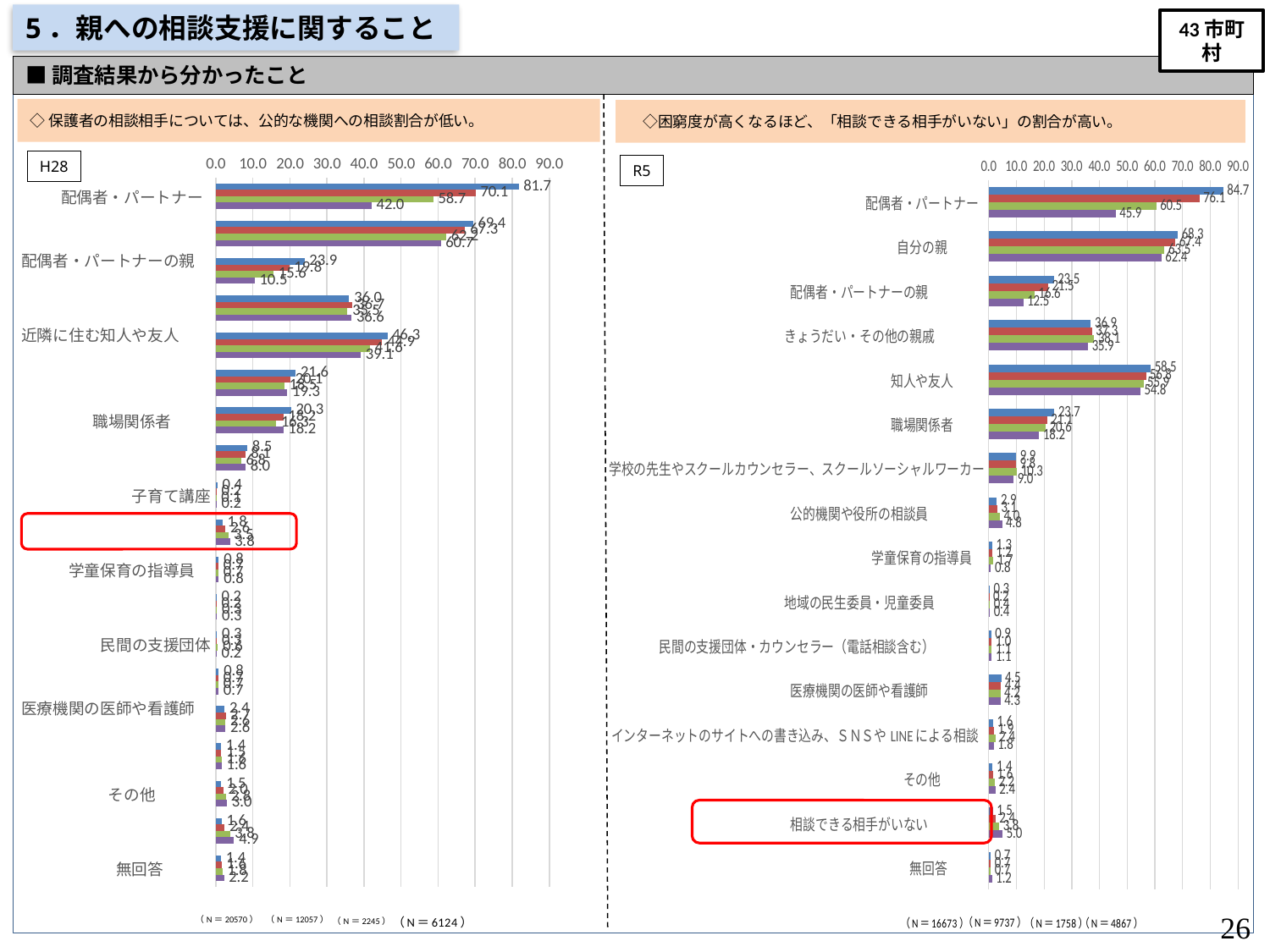
In the R5 chart on the right, what is the difference between the top (blue) bar and the bottom (purple) bar for 配偶者・パートナー? 38.8 In the H28 chart on the left, what is the value of the top (blue) bar for 配偶者・パートナー? 81.7 In the R5 chart on the right, what is the value of the bottom (purple) bar for 相談できる相手がいない? 5.0 In the R5 chart on the right, what is the value of the top (blue) bar for 相談できる相手がいない? 1.5 In the R5 chart on the right, how many categories are listed on the vertical axis? 16 In the R5 chart on the right, what is the value of the bottom (purple) bar for 配偶者・パートナー? 45.9 In the R5 chart on the right, is the top (blue) bar for 知人や友人 greater or less than 50.0? greater In the R5 chart on the right, which category is highlighted with a red box? 相談できる相手がいない What kind of chart is the R5 chart on the right? bar chart In the R5 chart on the right, what is the value of the top (blue) bar for 配偶者・パートナー? 84.7 In the R5 chart on the right, which is larger: the top (blue) bar for 自分の親 or the top (blue) bar for 配偶者・パートナーの親? 自分の親 In the R5 chart on the right, which category has the highest value? 配偶者・パートナー